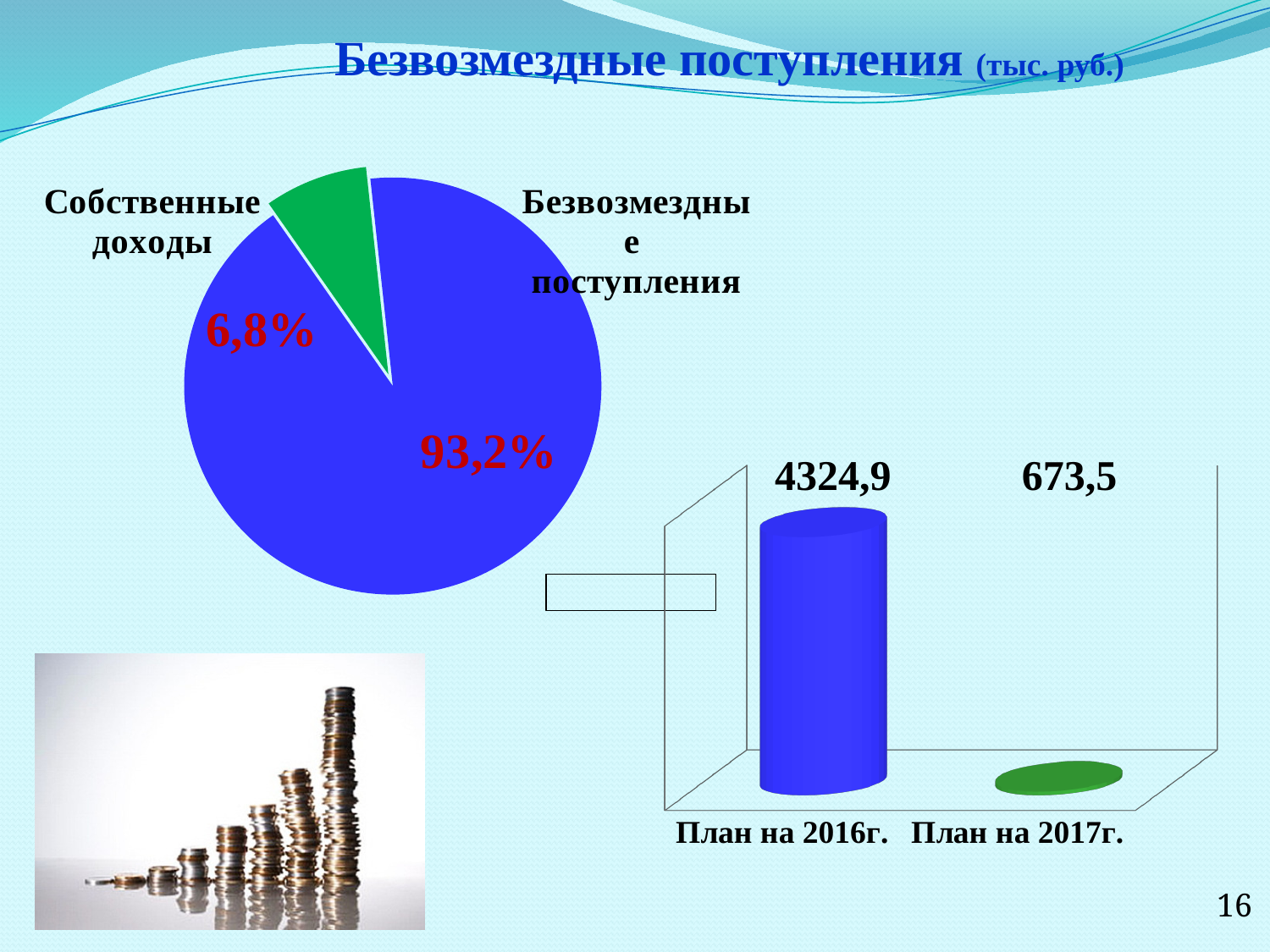
In the bar chart at the bottom right, do the values rise or fall from План на 2016г. to План на 2017г.? Fall In the bar chart at the bottom right, what is the value for План на 2016г.? 4324,9 How many slices does the pie chart have? 2 In the pie chart, what share is shown for Безвозмездные поступления? 93,2% In the pie chart, what share is shown for Собственные доходы? 6,8% In the bar chart at the bottom right, what is the difference between План на 2016г. and План на 2017г.? 3651,4 What kind of chart is shown at the bottom right of the slide? Bar chart In the pie chart, which slice is the largest? Безвозмездные поступления In the bar chart at the bottom right, which category has the higher value? План на 2016г. In the bar chart at the bottom right, what is the value for План на 2017г.? 673,5 In the pie chart, what colour is the Собственные доходы slice? Green In the pie chart, which slice is the smallest? Собственные доходы